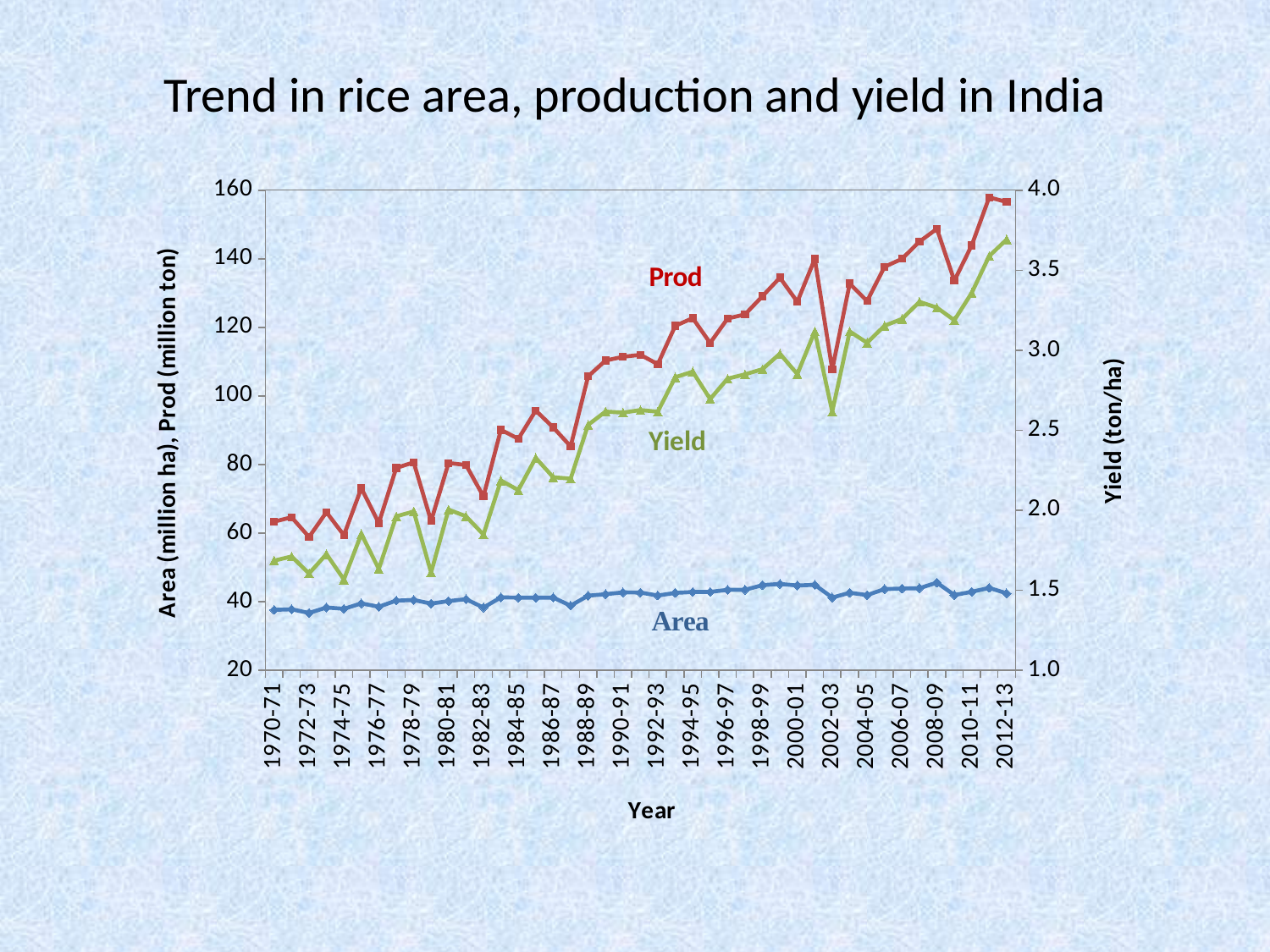
Is the Yield value in 1970-71 greater or less than 2.0 ton/ha? less What kind of chart is shown on the slide? line chart Is the value for Area in 2012-13 greater or less than 60? less What is the label of the right-hand vertical axis? Yield (ton/ha) Which is larger in 2012-13, the Prod value or the Area value? Prod What is the title of the chart? Trend in rice area, production and yield in India Is the value for Prod in 2002-03 greater or less than 120? less How many data series are plotted on the chart? 3 Does rice production (Prod) generally rise or fall from 1970-71 to 2012-13? rise